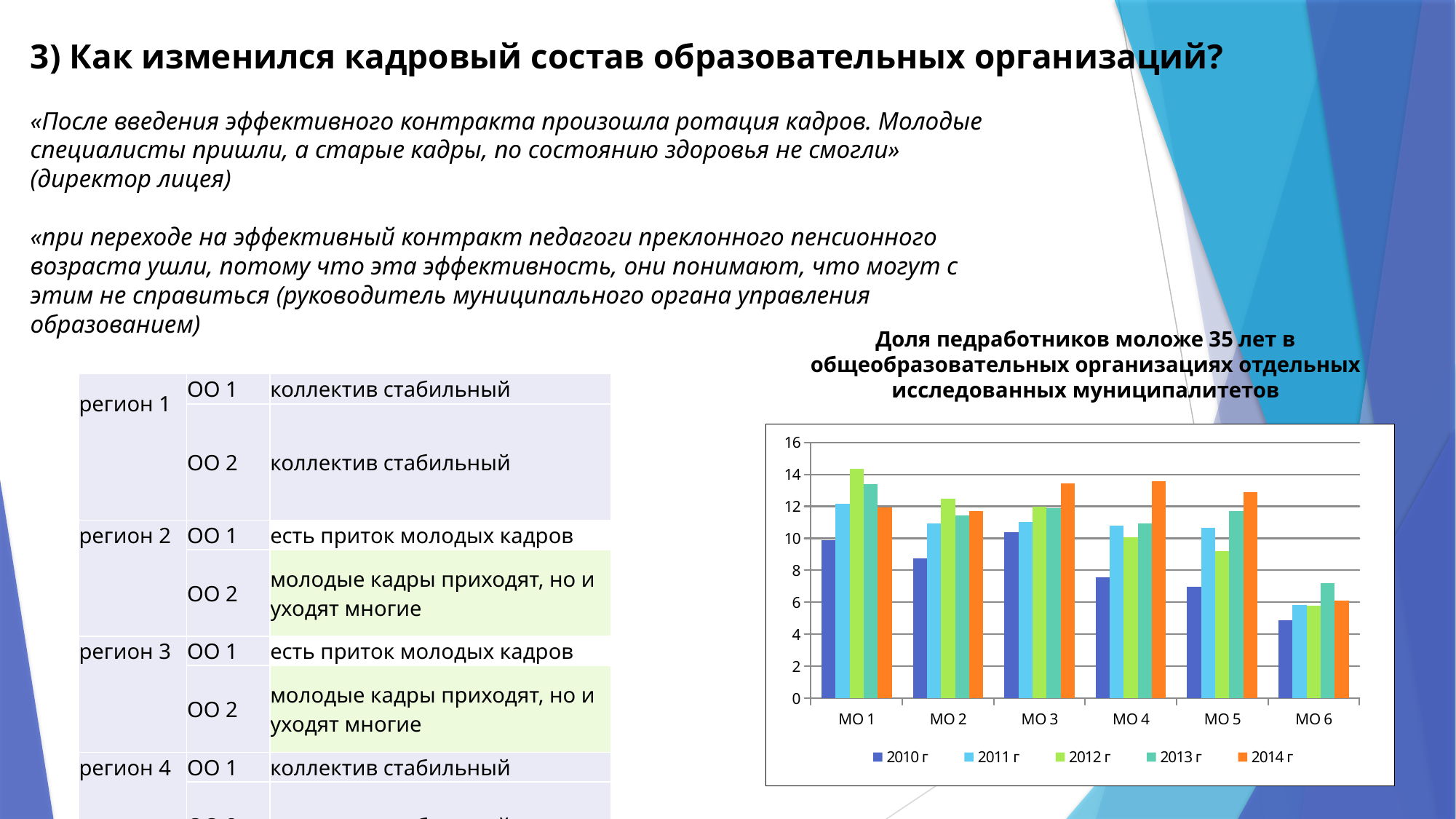
Is the value for МО 4 in the 2014 г series greater or less than 12? greater Is the value for МО 1 in the 2012 г series greater or less than 12? greater How many series does the chart legend list? 5 How many municipalities (МО categories) are shown on the x axis of the chart? 6 Does the 2010 г series rise or fall from МО 3 to МО 6? fall What is the first entry in the chart legend? 2010 г Is the value for МО 6 in the 2010 г series greater or less than 6? less Which municipality has the lowest value in the 2010 г series? МО 6 What kind of chart is shown on the slide? bar chart In the 2010 г series, which is larger: the value for МО 1 or the value for МО 6? МО 1 For МО 5, which is larger: the 2012 г value or the 2014 г value? 2014 г Which municipality has the highest value in the 2012 г series? МО 1